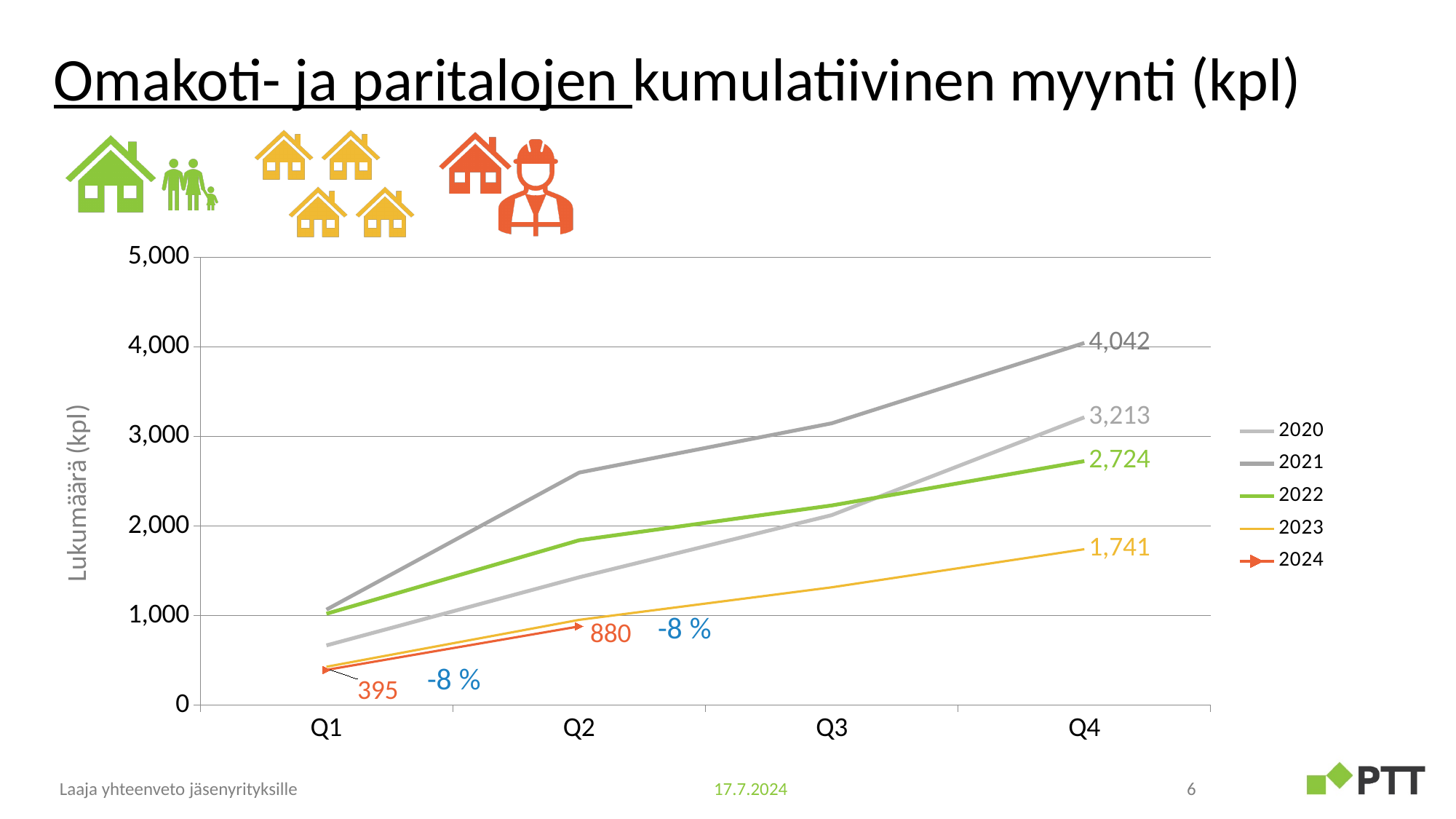
What kind of chart is shown on the slide? line chart How many series does the legend list? 5 Is the Q3 value for the 2021 series greater or less than 3,000? greater Does the 2020 series rise or fall from Q1 to Q4? rise What is the Q4 value for the 2021 series? 4,042 What is the Q2 value for the 2024 series? 880 Which is larger at Q4: the 2022 series or the 2023 series? 2022 What is the label on the vertical axis? Lukumäärä (kpl) What is the Q1 value for the 2024 series? 395 What is the difference between the Q4 values of the 2021 and 2020 series? 829 What is the Q4 value for the 2023 series? 1,741 Which series has the highest value at Q4? 2021